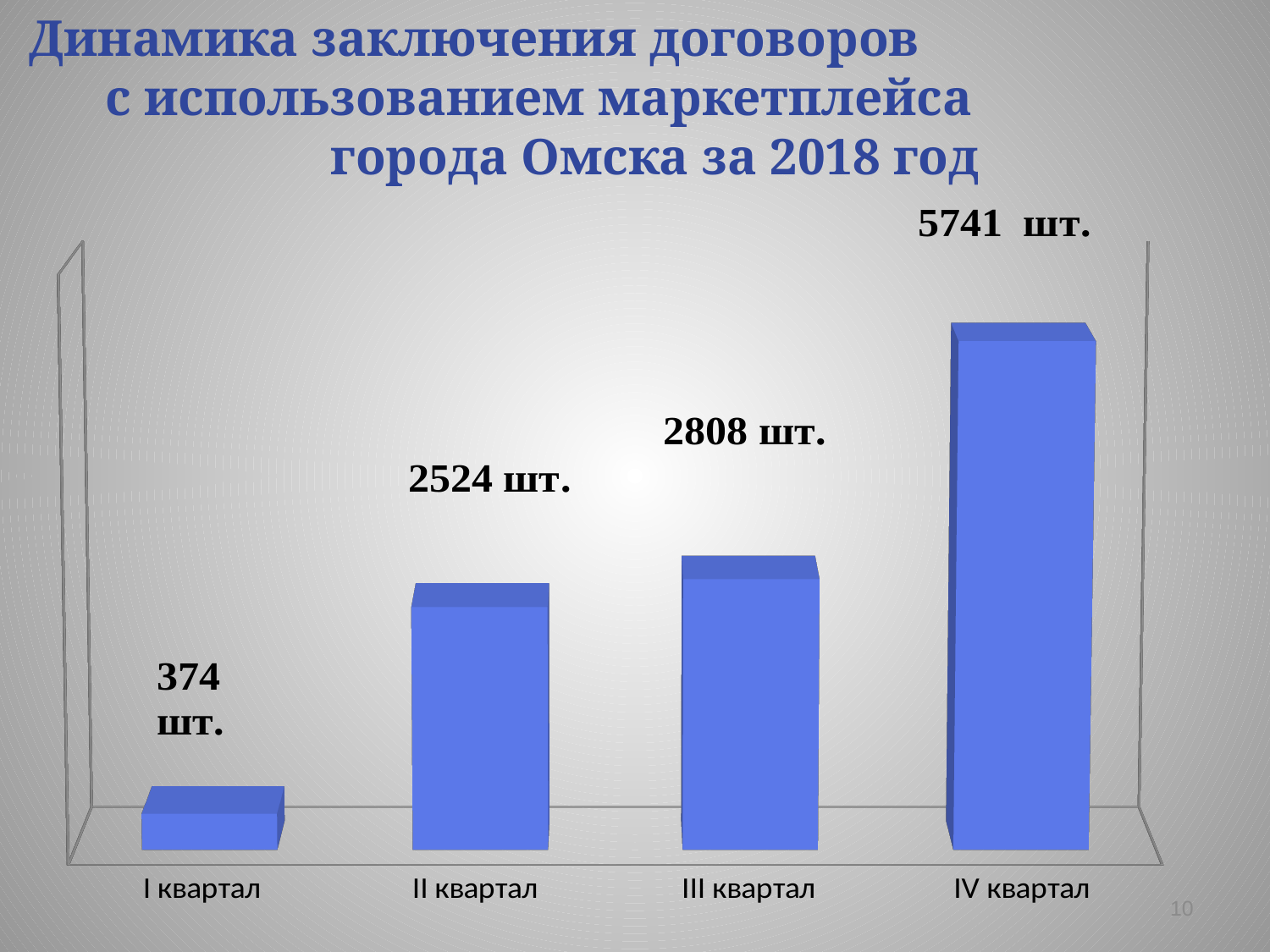
What is the value for III квартал? 2808 шт. How many categories are shown on the chart? 4 Do the values rise or fall from I квартал to IV квартал? Rise What is the difference between the values for IV квартал and III квартал? 2933 шт. What is the value for IV квартал? 5741 шт. Which quarter has the lowest value? I квартал What is the difference between the values for II квартал and I квартал? 2150 шт. What is the value for I квартал? 374 шт. What is the value for II квартал? 2524 шт. Which is larger, the value for II квартал or III квартал? III квартал What kind of chart is shown on the slide? Bar chart Which quarter has the highest value? IV квартал